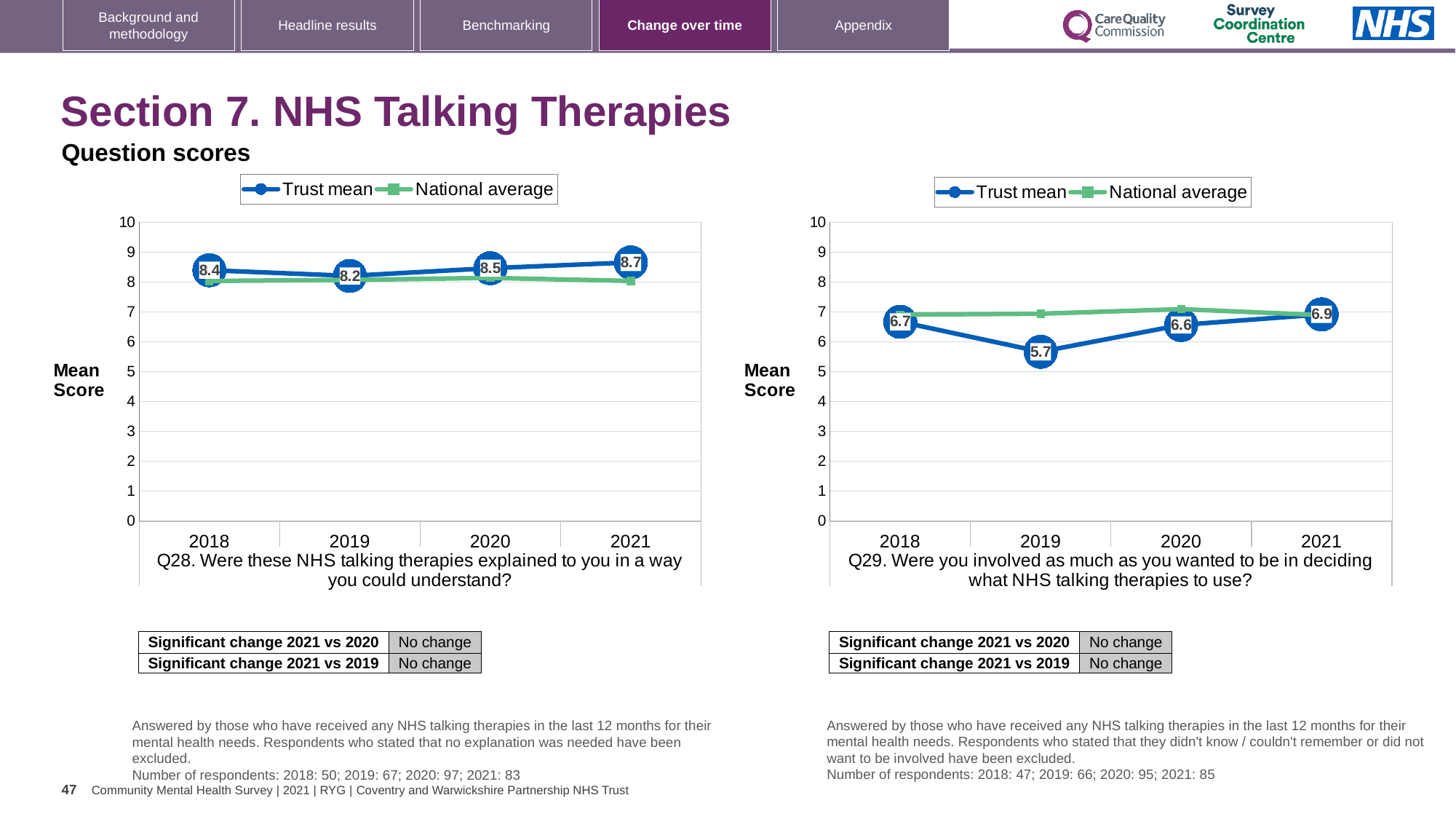
What kind of chart is the Q28 chart on the left? Line chart How many series does the legend of the Q29 chart on the right list? 2 In the Q28 chart on the left, what is the difference between the Trust mean in 2021 and in 2019? 0.5 In the Q28 chart on the left, is the National average for 2021 greater or less than 9? less In the Q28 chart on the left, does the Trust mean rise or fall from 2019 to 2021? Rise In the Q29 chart on the right, what is the difference between the Trust mean in 2021 and in 2019? 1.2 In the Q28 chart on the left, what is the Trust mean for 2021? 8.7 In the Q28 chart on the left, which year has the highest Trust mean? 2021 In the Q29 chart on the right, which year has the lowest Trust mean? 2019 How many years are plotted on the x axis of the Q28 chart on the left? 4 In the Q29 chart on the right, is the Trust mean higher in 2018 or in 2020? 2018 In the Q29 chart on the right, what is the Trust mean for 2019? 5.7